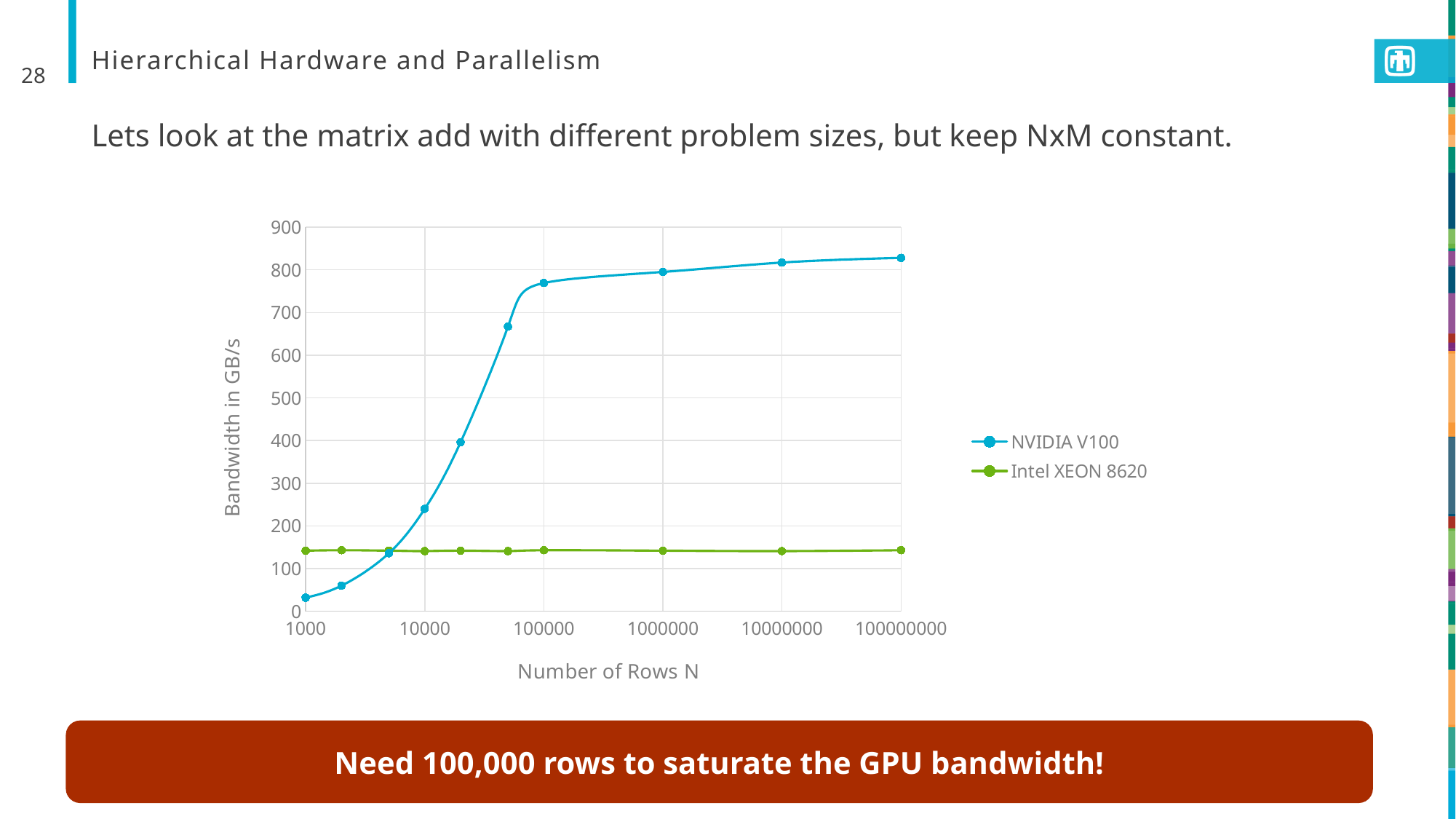
Is the NVIDIA V100 value at 1000 rows greater or less than 100? less Which two series are listed in the legend? NVIDIA V100 and Intel XEON 8620 How many series does the legend list? 2 What is the label of the y axis? Bandwidth in GB/s Is the Intel XEON 8620 value at 1000000 rows greater or less than 200? less At 1000 rows, which series has the higher bandwidth, NVIDIA V100 or Intel XEON 8620? Intel XEON 8620 What kind of chart is shown on the slide? line chart At which number of rows is the NVIDIA V100 bandwidth lowest? 1000 Is the NVIDIA V100 value at 100000 rows greater or less than 700? greater At 100000 rows, which series has the higher bandwidth, NVIDIA V100 or Intel XEON 8620? NVIDIA V100 Does the NVIDIA V100 bandwidth rise or fall as the number of rows increases? rise